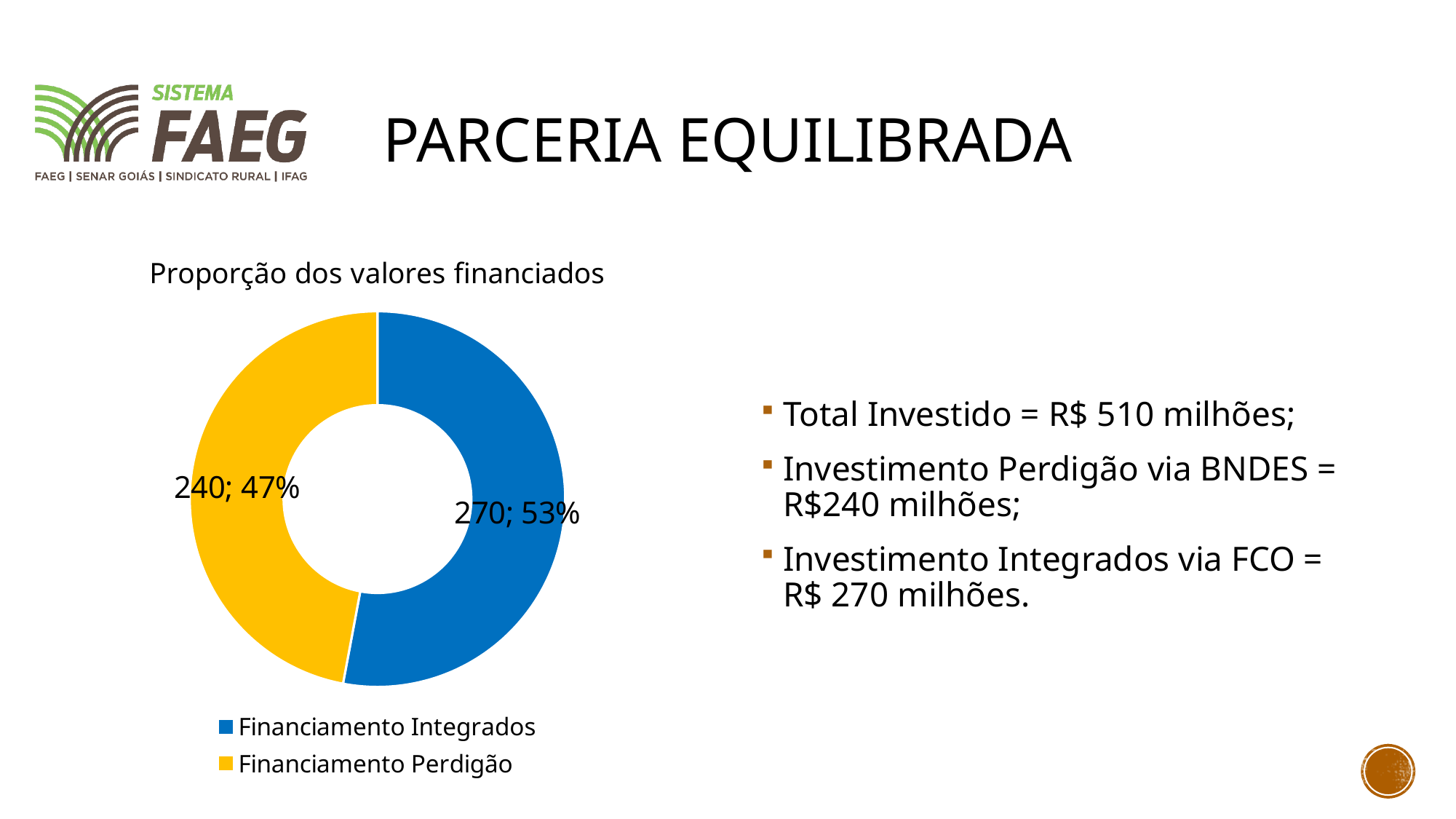
What is the difference between the values for Financiamento Integrados and Financiamento Perdigão? 30 What kind of chart is shown on the slide? Doughnut (pie) chart Which is larger, Financiamento Integrados or Financiamento Perdigão? Financiamento Integrados What is the value for Financiamento Integrados? 270 What colour is the Financiamento Perdigão slice? Yellow Which category has the smallest slice? Financiamento Perdigão What share of the chart does Financiamento Perdigão represent? 47% What is the title of the chart? Proporção dos valores financiados What share of the chart does Financiamento Integrados represent? 53% What is the value for Financiamento Perdigão? 240 How many slices does the chart have? 2 Which category has the largest slice? Financiamento Integrados